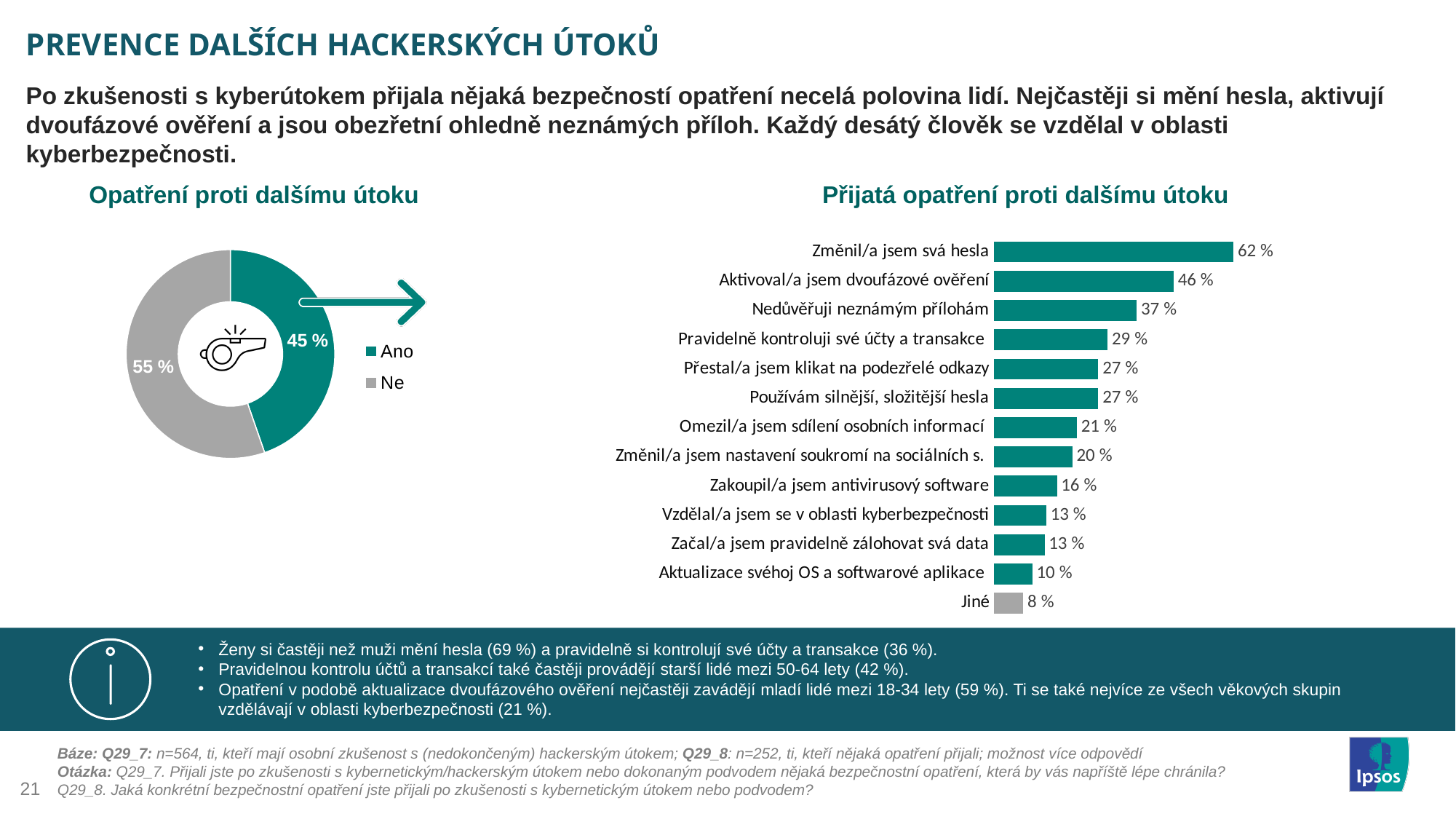
How many categories are shown in the 'Přijatá opatření proti dalšímu útoku' chart? 13 In the 'Opatření proti dalšímu útoku' chart, what share of respondents answered 'Ne'? 55 % In the 'Přijatá opatření proti dalšímu útoku' chart, what is the value for 'Změnil/a jsem svá hesla'? 62 % In the 'Přijatá opatření proti dalšímu útoku' chart, what is the difference between 'Změnil/a jsem svá hesla' and 'Aktivoval/a jsem dvoufázové ověření'? 16 % In the 'Přijatá opatření proti dalšímu útoku' chart, which is larger: 'Nedůvěřuji neznámým přílohám' or 'Pravidelně kontroluji své účty a transakce'? Nedůvěřuji neznámým přílohám How many series does the legend of the 'Opatření proti dalšímu útoku' chart list? 2 In the 'Přijatá opatření proti dalšímu útoku' chart, which category has the lowest value? Jiné What kind of chart is 'Přijatá opatření proti dalšímu útoku'? Bar chart In the 'Přijatá opatření proti dalšímu útoku' chart, what is the value for 'Zakoupil/a jsem antivirusový software'? 16 % In the 'Opatření proti dalšímu útoku' chart, what share of respondents answered 'Ano'? 45 % What kind of chart is 'Opatření proti dalšímu útoku'? Doughnut (pie) chart In the 'Přijatá opatření proti dalšímu útoku' chart, which category has the highest value? Změnil/a jsem svá hesla